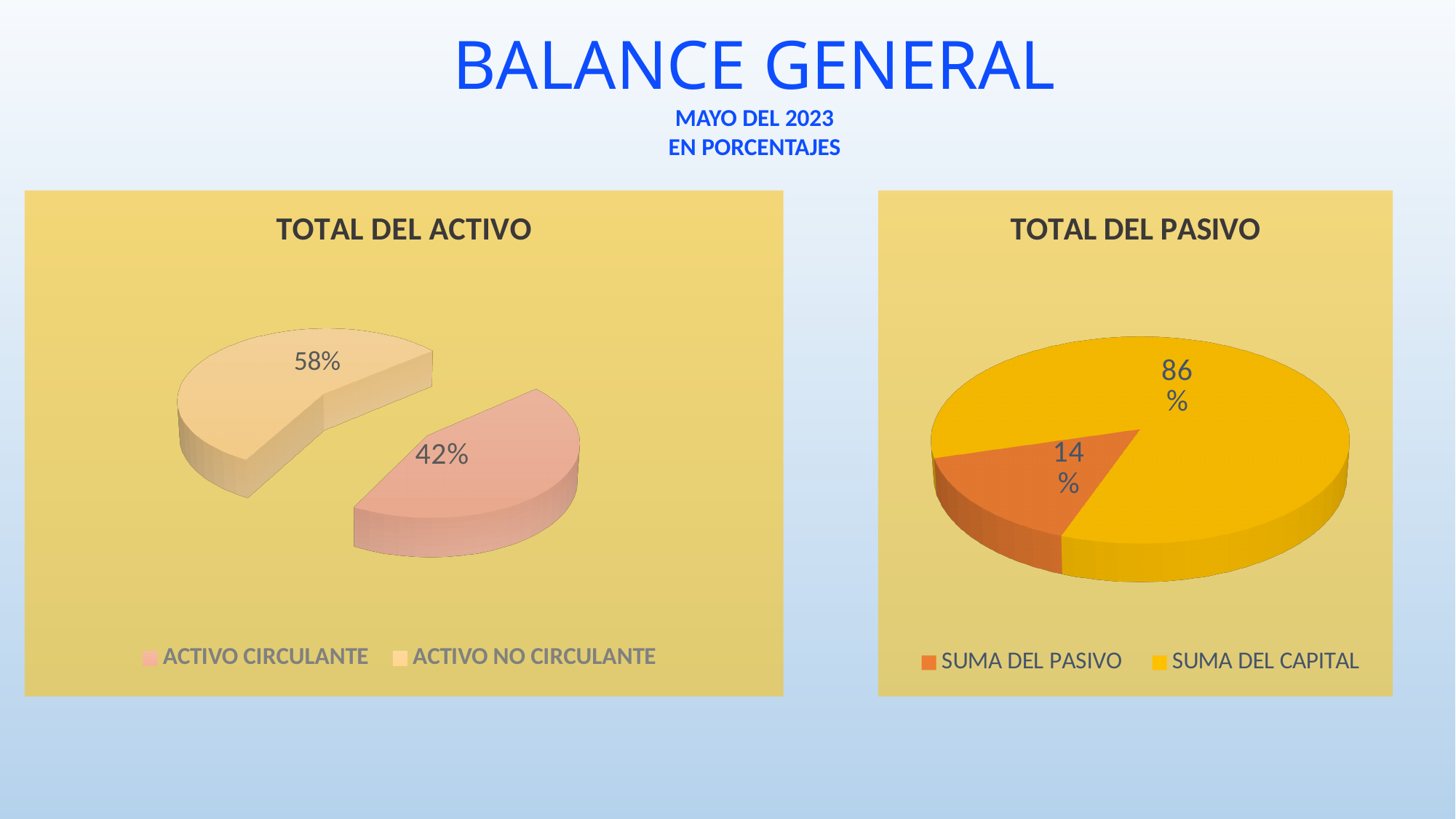
In the 'TOTAL DEL ACTIVO' chart, what percentage is shown for ACTIVO NO CIRCULANTE? 58% What kind of chart is the 'TOTAL DEL ACTIVO' chart? Pie chart In the 'TOTAL DEL PASIVO' chart, which category has the smallest slice? SUMA DEL PASIVO What is the title of the chart on the left side of the slide? TOTAL DEL ACTIVO In the 'TOTAL DEL ACTIVO' chart, what percentage is shown for ACTIVO CIRCULANTE? 42% In the 'TOTAL DEL PASIVO' chart, what is the difference in percentage points between SUMA DEL CAPITAL and SUMA DEL PASIVO? 72 In the 'TOTAL DEL PASIVO' chart, what percentage is shown for SUMA DEL PASIVO? 14% In the 'TOTAL DEL PASIVO' chart, what percentage is shown for SUMA DEL CAPITAL? 86% In the 'TOTAL DEL ACTIVO' chart, what is the difference in percentage points between ACTIVO NO CIRCULANTE and ACTIVO CIRCULANTE? 16 In the 'TOTAL DEL ACTIVO' chart, which category has the largest slice? ACTIVO NO CIRCULANTE How many categories does the legend of the 'TOTAL DEL PASIVO' chart list? 2 In the 'TOTAL DEL PASIVO' chart, which is larger, SUMA DEL PASIVO or SUMA DEL CAPITAL? SUMA DEL CAPITAL